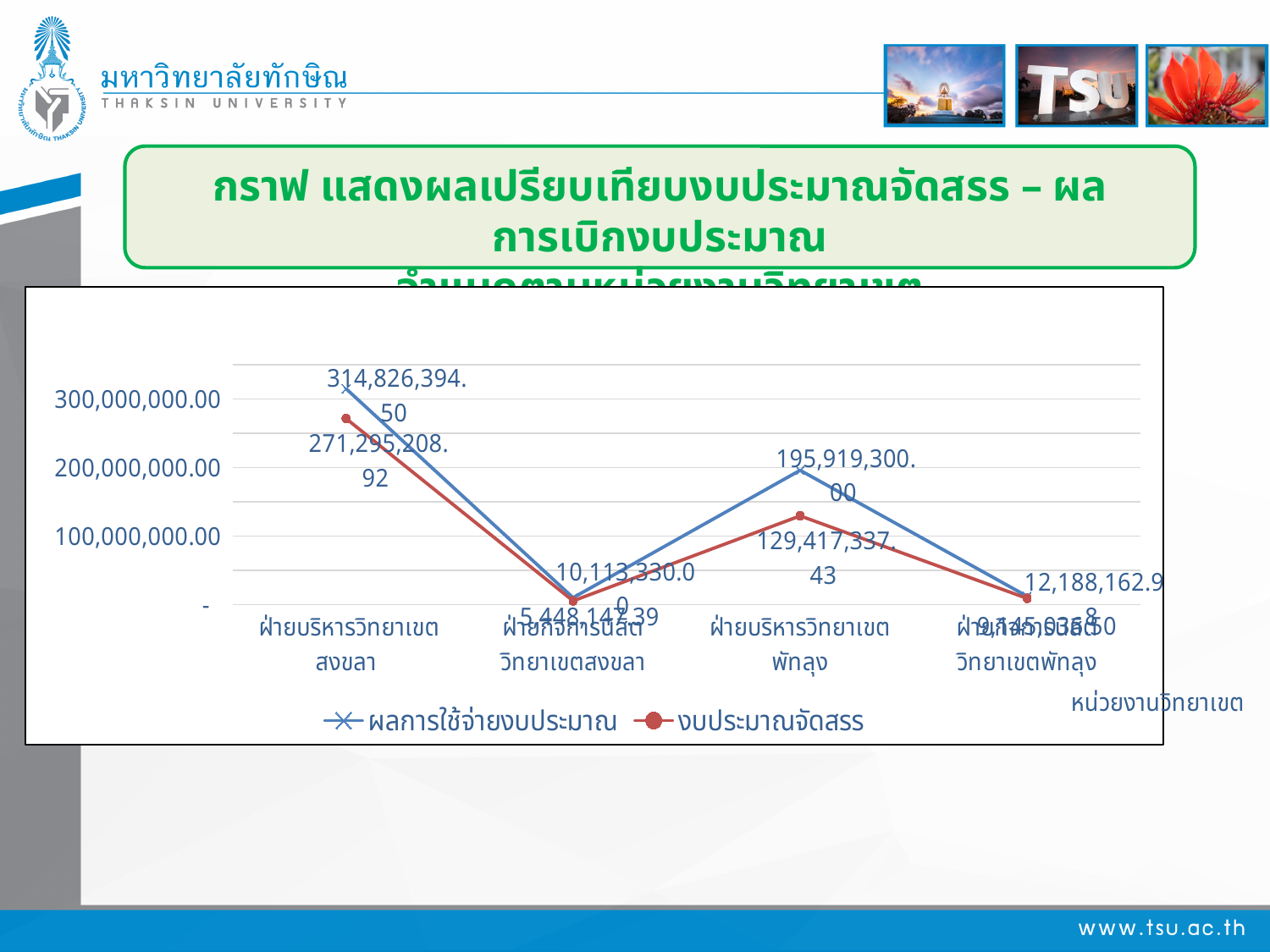
What is the value of ผลการใช้จ่ายงบประมาณ for ฝ่ายบริหารวิทยาเขตสงขลา? 314,826,394.50 For ฝ่ายบริหารวิทยาเขตสงขลา, which is larger: ผลการใช้จ่ายงบประมาณ or งบประมาณจัดสรร? ผลการใช้จ่ายงบประมาณ Which category has the highest value for ผลการใช้จ่ายงบประมาณ? ฝ่ายบริหารวิทยาเขตสงขลา How many series does the chart legend list? 2 What is the value of งบประมาณจัดสรร for ฝ่ายกิจการนิสิตวิทยาเขตสงขลา? 5,448,147.39 Which category has the lowest value for งบประมาณจัดสรร? ฝ่ายกิจการนิสิตวิทยาเขตสงขลา How many categories are shown on the x axis of the chart? 4 What is the difference between ผลการใช้จ่ายงบประมาณ and งบประมาณจัดสรร for ฝ่ายบริหารวิทยาเขตพัทลุง? 66,501,962.57 What is the value of ผลการใช้จ่ายงบประมาณ for ฝ่ายบริหารวิทยาเขตพัทลุง? 195,919,300.00 What is the value of งบประมาณจัดสรร for ฝ่ายบริหารวิทยาเขตสงขลา? 271,295,208.92 Is the value of งบประมาณจัดสรร for ฝ่ายบริหารวิทยาเขตพัทลุง greater or less than 100,000,000.00? greater What kind of chart is shown on the slide? line chart